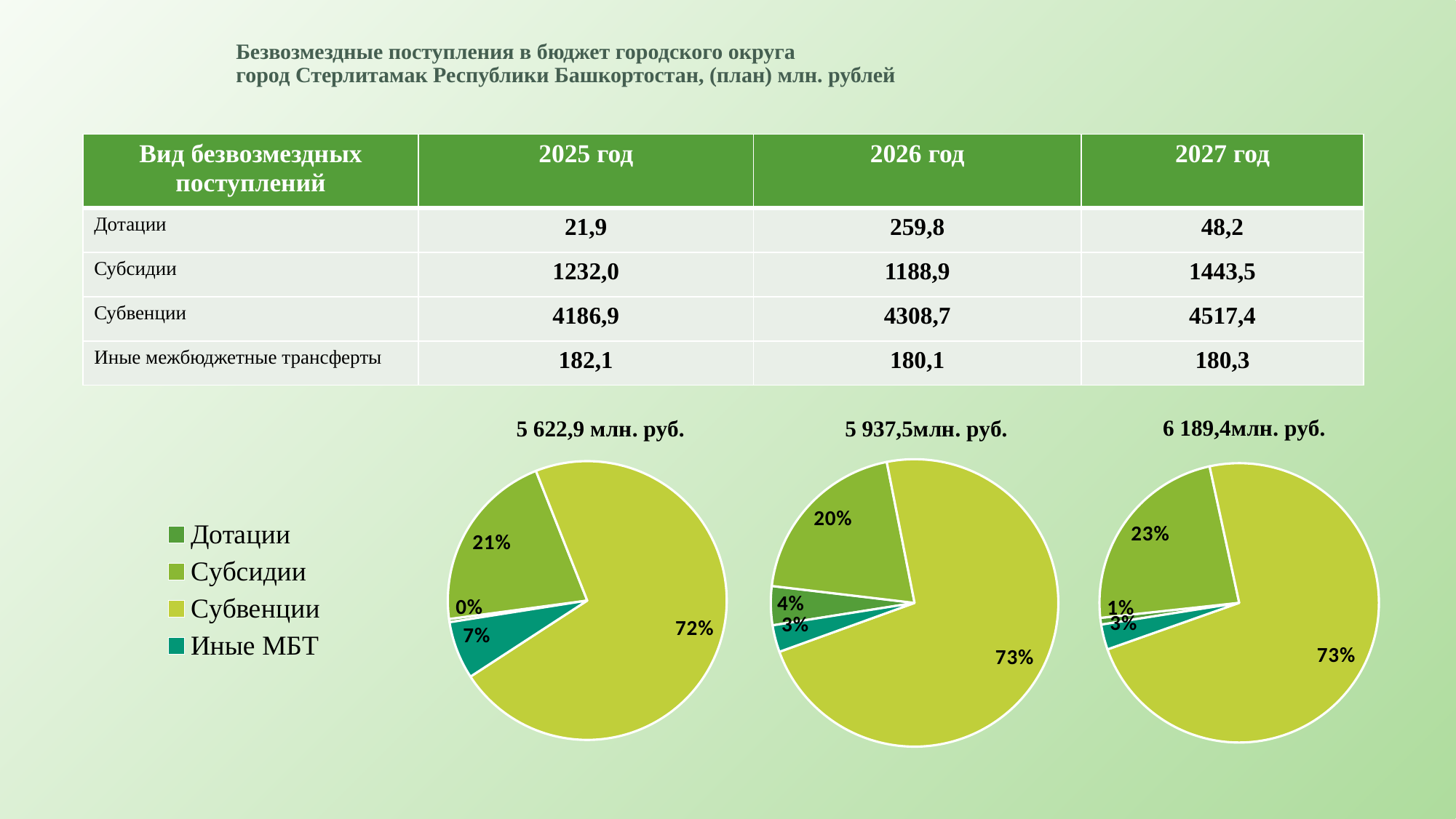
In the middle pie chart titled "5 937,5млн. руб.", what is the difference in percentage points between the Субвенции share and the Субсидии share? 53 In the right pie chart titled "6 189,4млн. руб.", what share does Дотации have? 1% In the right pie chart titled "6 189,4млн. руб.", which is larger, the share of Субсидии or the share of Иные МБТ? Субсидии In the middle pie chart titled "5 937,5млн. руб.", what share does Субсидии have? 20% What kind of chart is used on the slide? Pie chart In the left pie chart titled "5 622,9 млн. руб.", what share does Иные МБТ have? 7% How many entries does the legend list? 4 In the left pie chart titled "5 622,9 млн. руб.", which category has the largest share? Субвенции In the left pie chart titled "5 622,9 млн. руб.", which category has the smallest share? Дотации